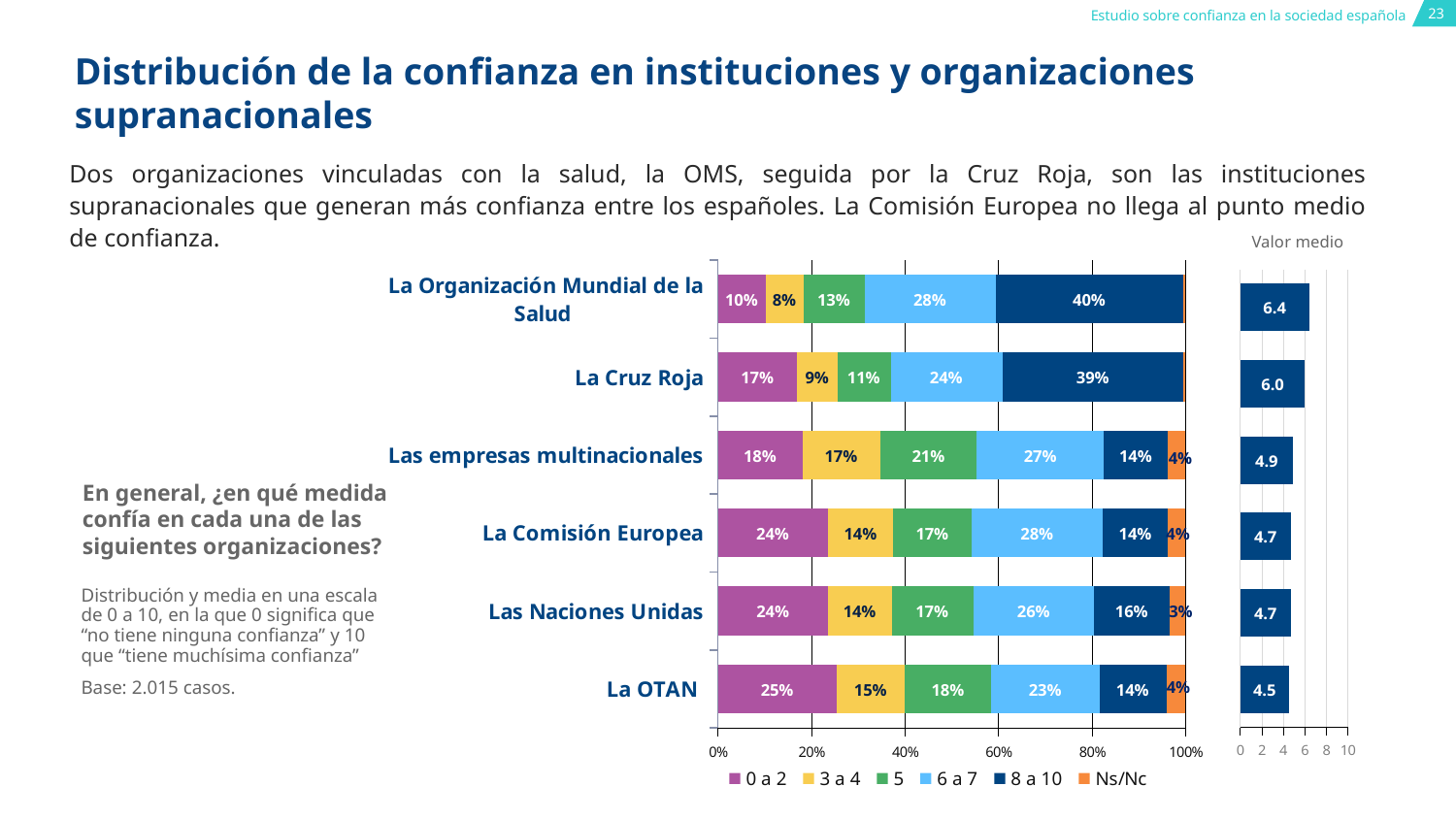
What type of chart is used to show the distribution of confidence across organizations? Stacked bar chart In the stacked bar chart, what percentage of respondents gave La Organización Mundial de la Salud a score of 8 a 10? 40% In the stacked bar chart, which has a larger 0 a 2 share: La Comisión Europea or La Cruz Roja? La Comisión Europea In the Valor medio chart, what is the mean value for La Cruz Roja? 6.0 How many organizations are shown in the stacked bar chart? 6 In the Valor medio chart, which organization has the highest mean value? La Organización Mundial de la Salud In the stacked bar chart, what percentage of respondents gave La OTAN a score of 0 a 2? 25% How many series does the legend of the stacked bar chart list? 6 In the stacked bar chart, what percentage of respondents gave Las Naciones Unidas a score of 6 a 7? 26% In the Valor medio chart, what is the difference between the mean values of La Organización Mundial de la Salud and La Cruz Roja? 0.4 In the Valor medio chart, which organization has the lowest mean value? La OTAN What is the title of the small chart to the right of the stacked bars? Valor medio